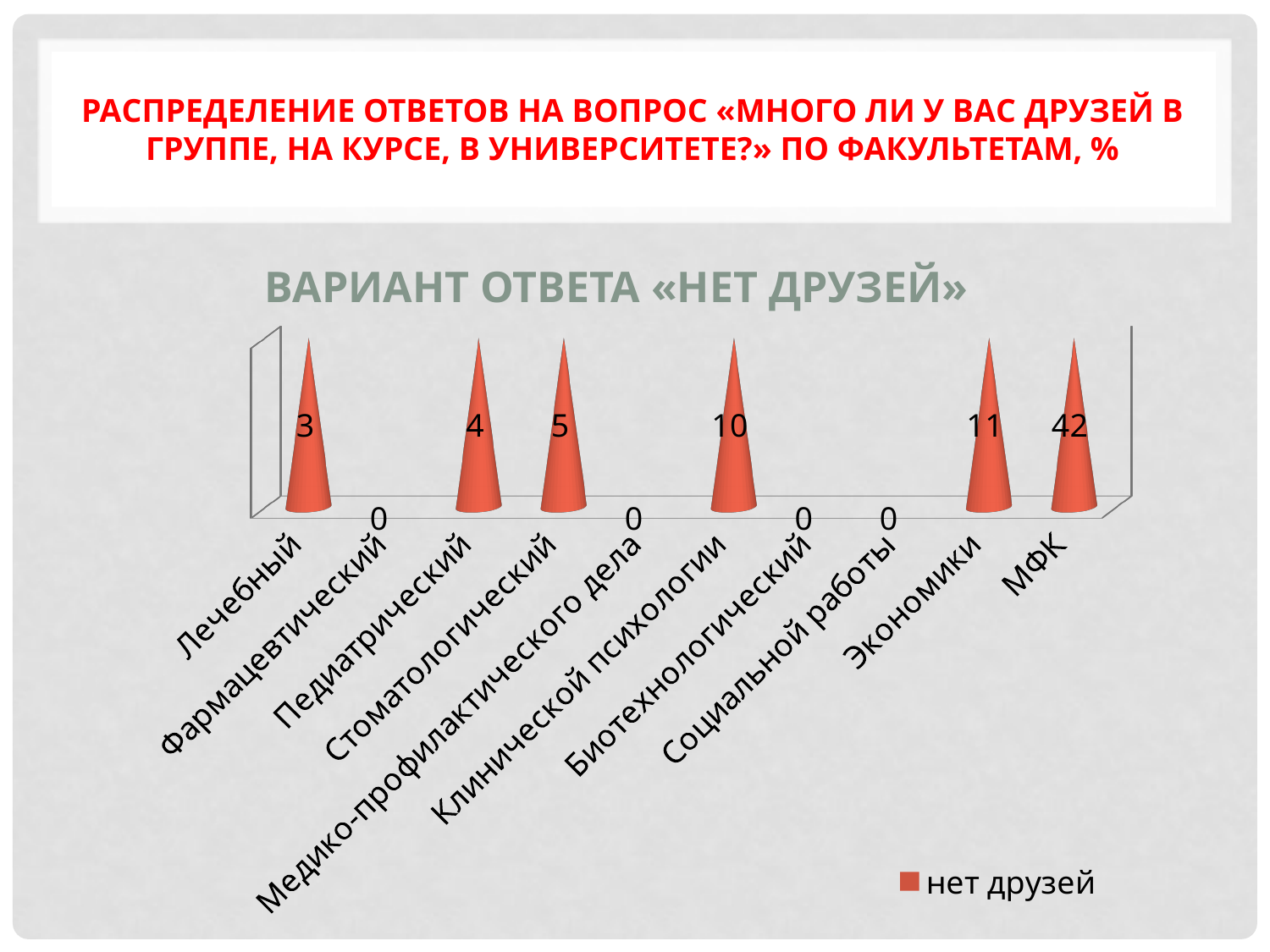
What is the title of the chart? Вариант ответа «нет друзей» What is the value for Фармацевтический? 0 How many faculties are shown on the x axis? 10 How many series does the legend list? 1 What is the value for Клинической психологии? 10 What is the value for МФК? 42 What is the value for Экономики? 11 What is the difference between the values for Стоматологический and Педиатрический? 1 Which is larger, the value for Клинической психологии or the value for Стоматологический? Клинической психологии Which faculty has the highest value? МФК What is the value for Лечебный? 3 What is the difference between the values for МФК and Экономики? 31